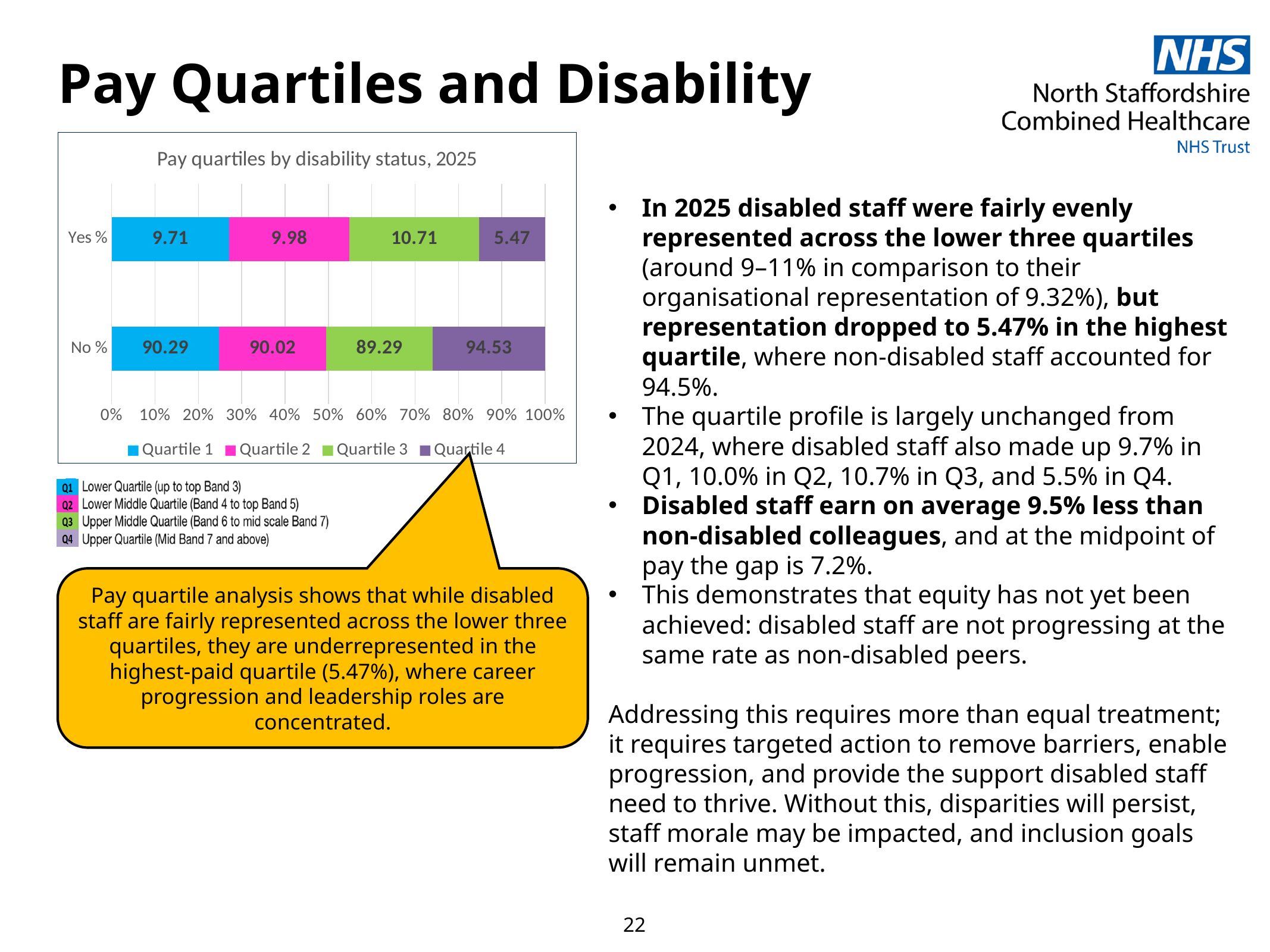
What is the Quartile 1 value for the Yes % bar? 9.71 What is the Quartile 2 value for the No % bar? 90.02 In the No % bar, which is larger: the Quartile 3 value or the Quartile 4 value? Quartile 4 How many categories (bars) are shown on the y axis? 2 What is the Quartile 3 value for the Yes % bar? 10.71 Which quartile has the lowest value in the Yes % bar? Quartile 4 How many series does the legend list? 4 What is the difference between the Quartile 3 and Quartile 4 values in the Yes % bar? 5.24 Which quartile has the highest value in the Yes % bar? Quartile 3 What is the title of the chart? Pay quartiles by disability status, 2025 What is the difference between the Quartile 4 values for No % and Yes %? 89.06 What is the Quartile 4 value for the No % bar? 94.53